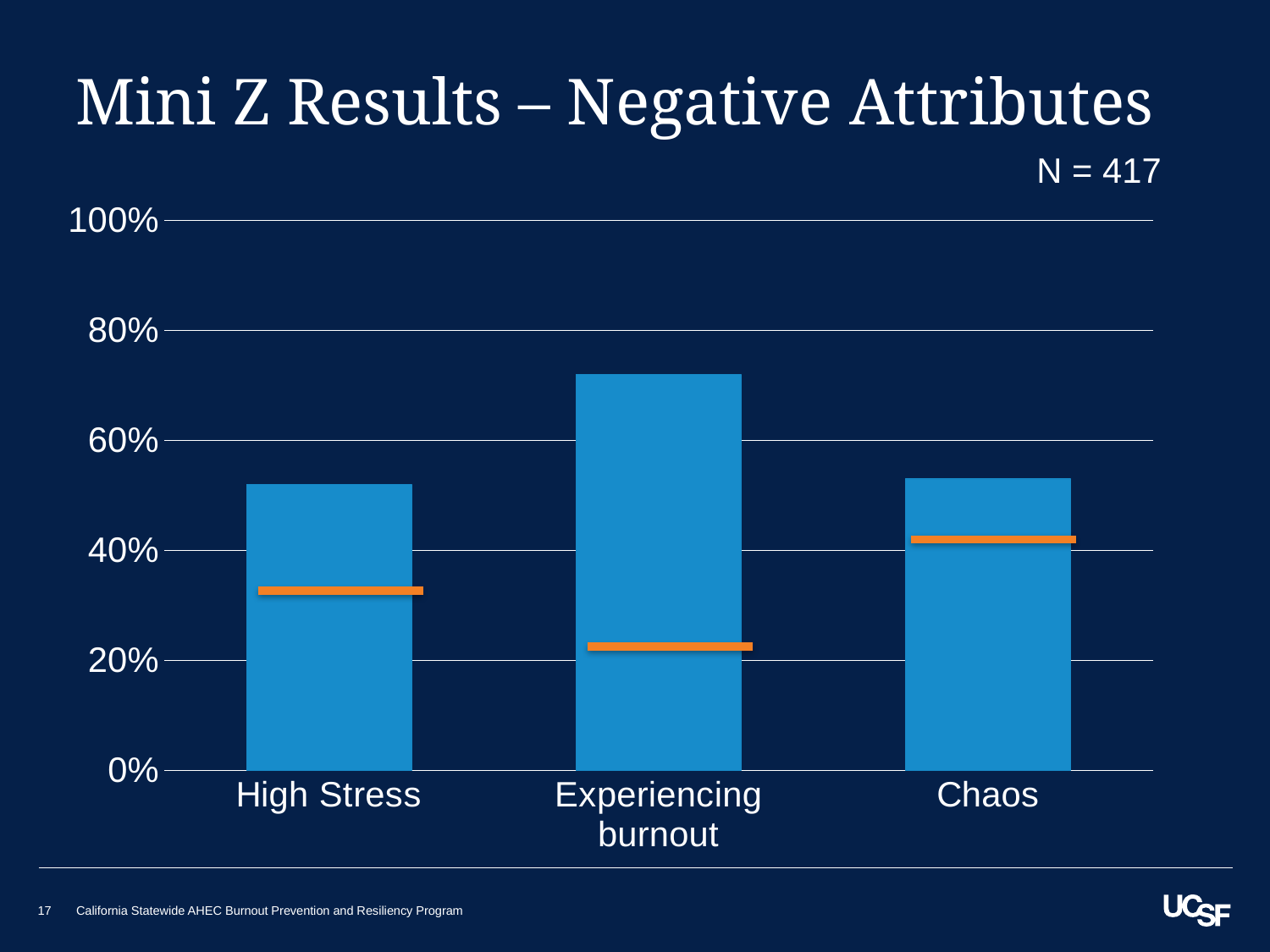
Is the blue bar for Experiencing burnout greater or less than 80%? less Is the blue bar for High Stress greater or less than 40%? greater Is the orange marker for Experiencing burnout greater or less than 40%? less What sample size (N) is stated on the slide? N = 417 What is the title of the slide containing the chart? Mini Z Results – Negative Attributes Which blue bar is taller, High Stress or Experiencing burnout? Experiencing burnout How many categories are shown on the x axis of the chart? 3 What kind of chart is shown on the slide? bar chart Which category has the tallest blue bar? Experiencing burnout